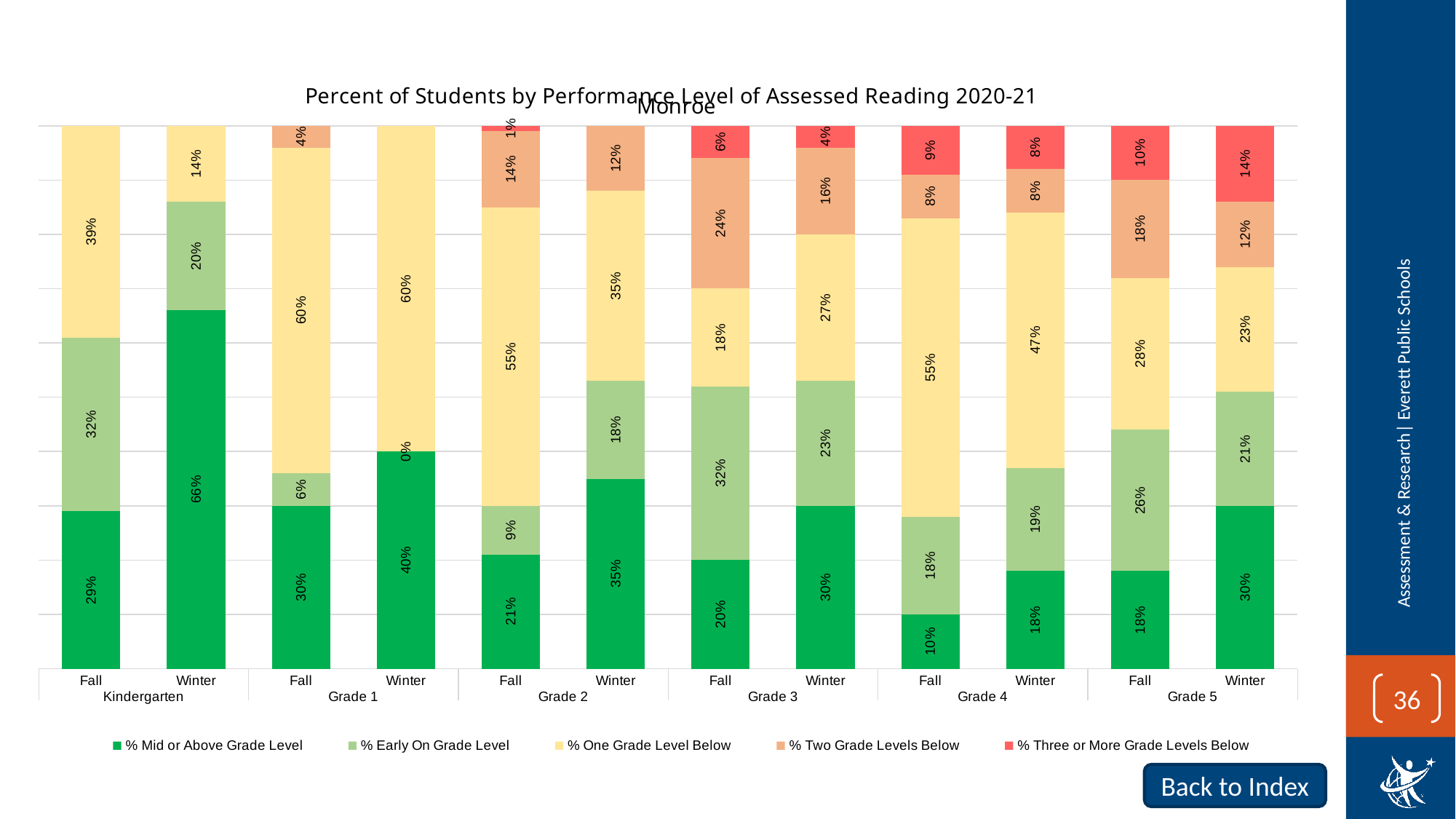
Which is larger: the % Early On Grade Level value for Grade 3 Fall or for Grade 3 Winter? Grade 3 Fall Which bar has the lowest % Mid or Above Grade Level value? Grade 4 Fall What is the % One Grade Level Below value for Grade 1 Fall? 60% What percentage of Kindergarten Winter students are at % Mid or Above Grade Level? 66% What is the % Two Grade Levels Below value for Grade 3 Fall? 24% Which bar has the highest % Mid or Above Grade Level value? Kindergarten Winter What type of chart is shown on the slide? Stacked bar chart How many bars are plotted in the chart? 12 How many series does the legend list? 5 Which school is named in the chart title? Monroe What is the % Three or More Grade Levels Below value for Grade 5 Winter? 14% What is the difference between the % Mid or Above Grade Level values for Grade 2 Winter and Grade 2 Fall? 14%